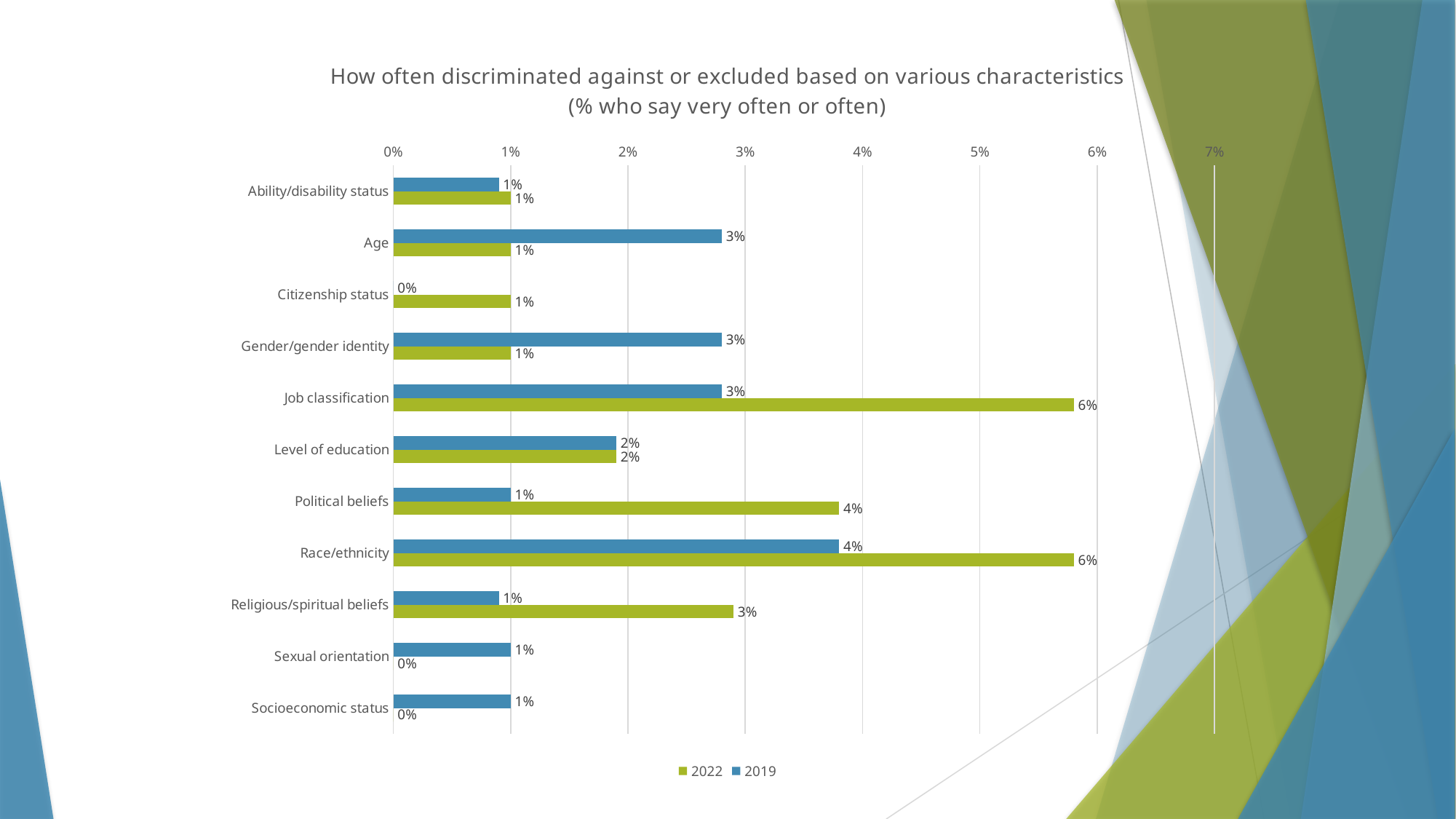
What is the 2022 value for Job classification? 6% What is the difference between the 2022 and 2019 values for Job classification? 3% For Age, which year has the larger value, 2019 or 2022? 2019 How many series does the legend list? 2 What is the 2019 value for Citizenship status? 0% What is the 2022 value for Political beliefs? 4% Is the 2022 value for Race/ethnicity greater or less than 5%? greater Which category has the lowest 2019 value? Citizenship status Which category has the highest 2019 value? Race/ethnicity How many characteristics (categories) are shown on the chart? 11 What kind of chart is shown on the slide? Bar chart What is the 2019 value for Race/ethnicity? 4%